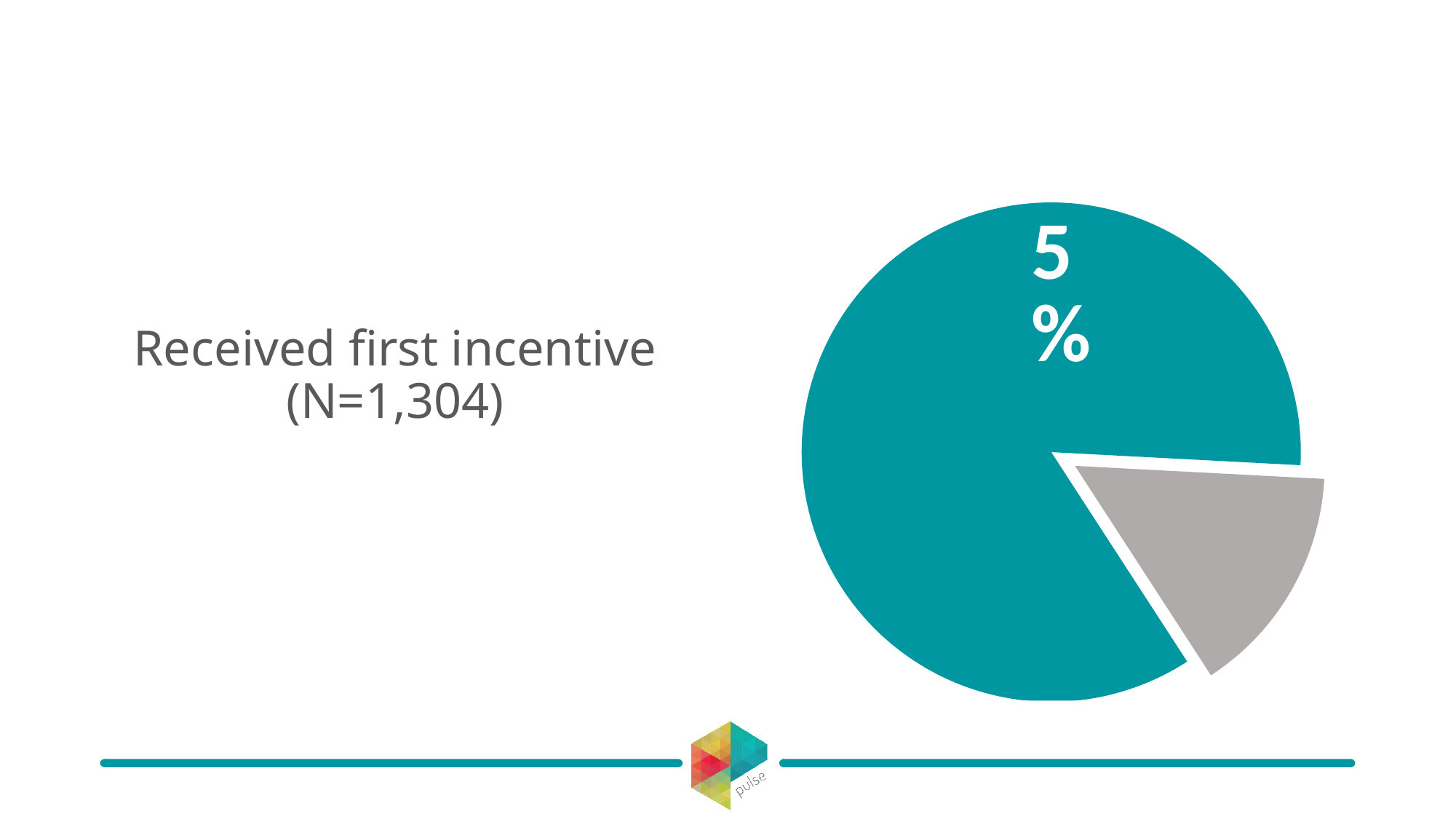
Which slice of the pie chart is the smallest? the grey slice Which slice of the pie chart is larger, the teal one or the grey one? the teal one What sample size (N) is stated for the pie chart? 1,304 What is the title text shown next to the pie chart? Received first incentive (N=1,304) Does the teal slice cover more or less than half of the pie? more Which slice of the pie chart is the largest? the teal slice What kind of chart is shown on the slide? pie chart How many slices does the pie chart have? 2